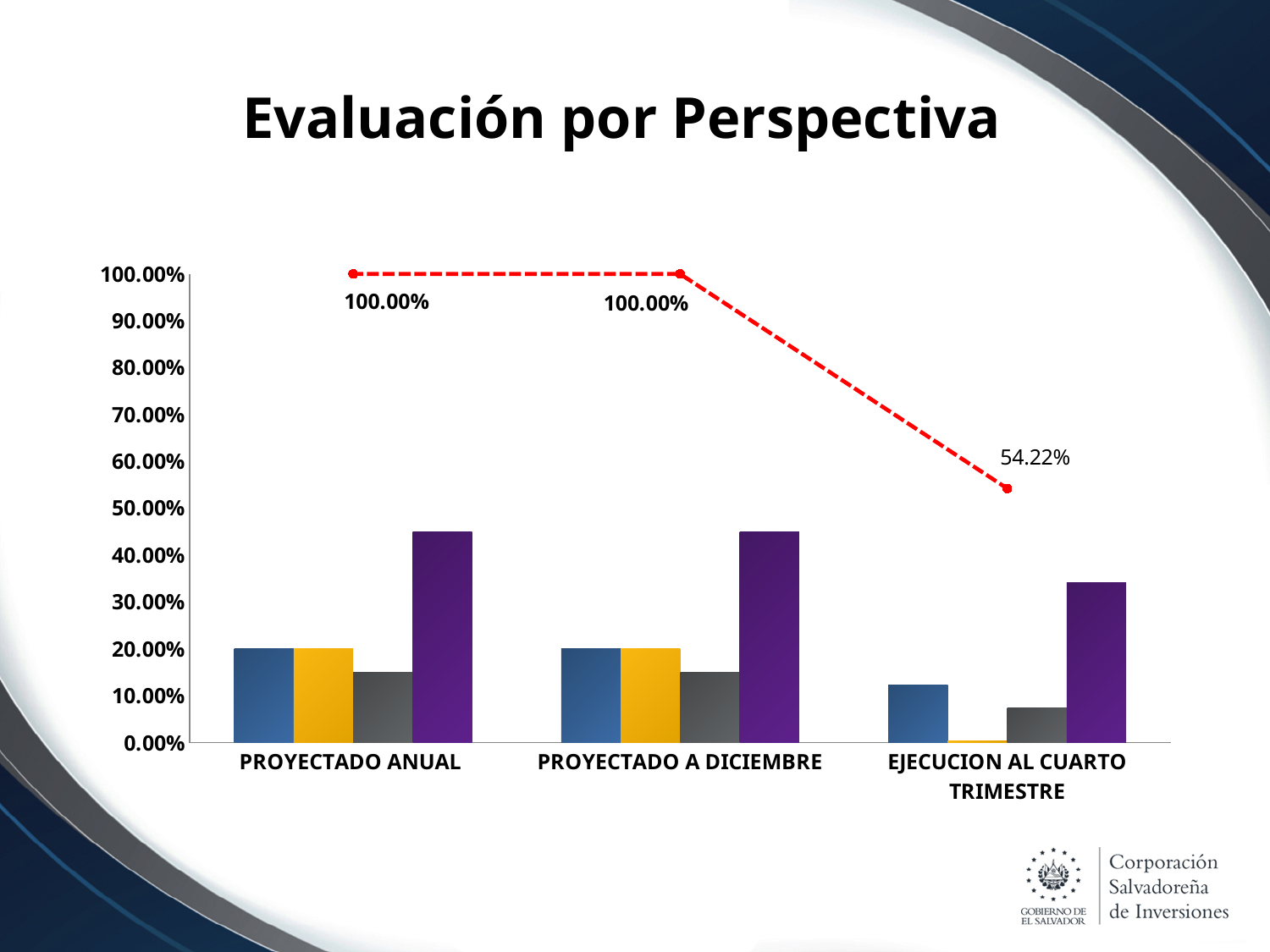
What value does the dashed red line show for EJECUCION AL CUARTO TRIMESTRE? 54.22% For which category is the dashed red line value lowest? EJECUCION AL CUARTO TRIMESTRE Which is larger: the purple bar for PROYECTADO ANUAL or the purple bar for EJECUCION AL CUARTO TRIMESTRE? PROYECTADO ANUAL What is the title of the chart on the slide? Evaluación por Perspectiva What value does the dashed red line show for PROYECTADO A DICIEMBRE? 100.00% How many categories are shown on the x axis? 3 What kind of chart is shown on the slide? Combined bar and line chart Does the dashed red line rise or fall from PROYECTADO A DICIEMBRE to EJECUCION AL CUARTO TRIMESTRE? Falls What value does the dashed red line show for PROYECTADO ANUAL? 100.00% Is the blue bar for EJECUCION AL CUARTO TRIMESTRE greater or less than 20.00%? less What is the difference between the dashed red line values for PROYECTADO A DICIEMBRE and EJECUCION AL CUARTO TRIMESTRE? 45.78% Is the purple bar for PROYECTADO ANUAL greater or less than 40.00%? greater